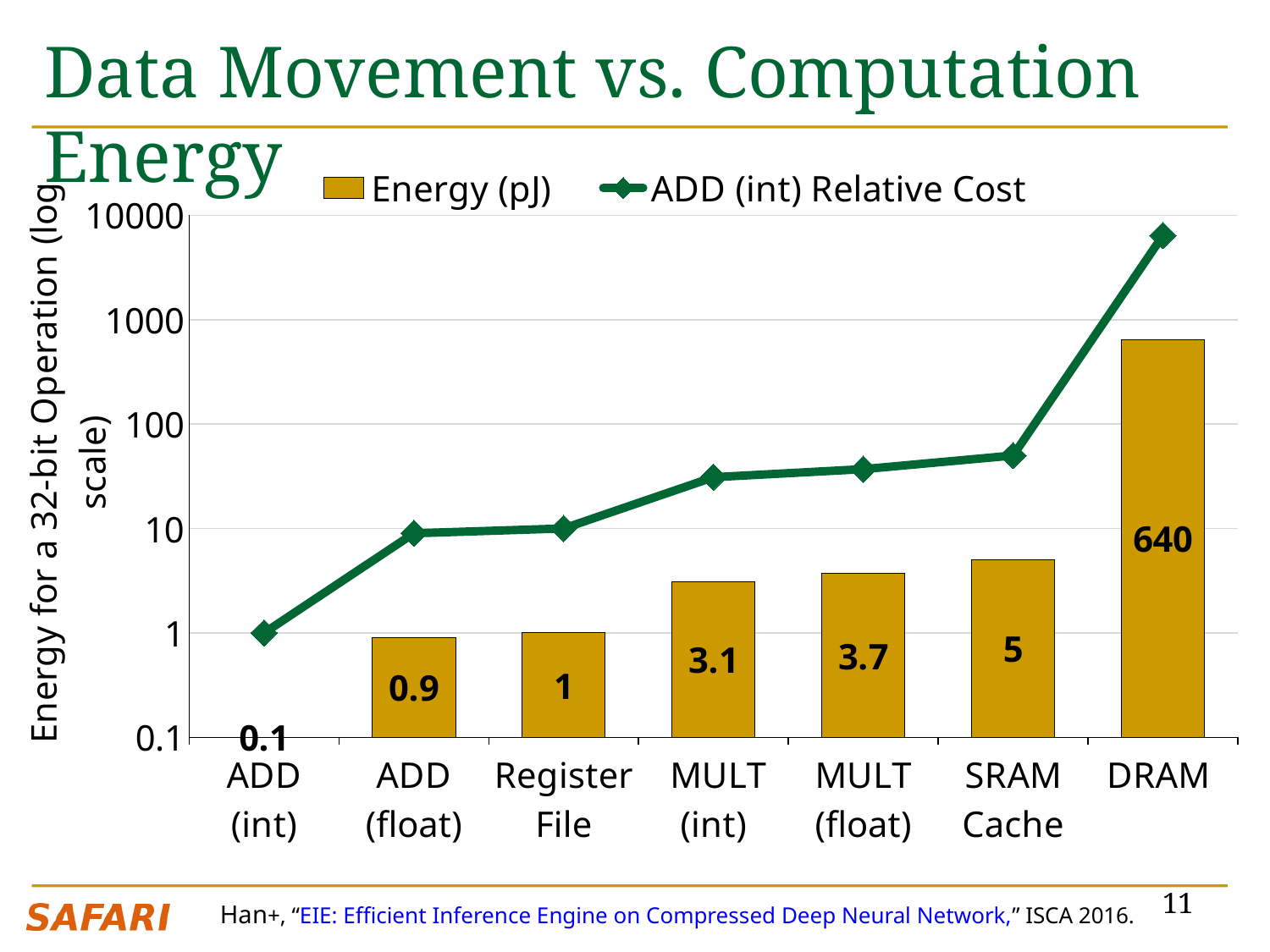
Do the Energy (pJ) values generally rise or fall from ADD (float) to DRAM along the x axis? rise Is the ADD (int) Relative Cost value for SRAM Cache greater or less than 100? less How many series does the legend list? 2 How many categories are shown on the x axis? 7 Is the ADD (int) Relative Cost value for DRAM greater or less than 1000? greater What is the difference in Energy (pJ) between SRAM Cache and MULT (int)? 1.9 Which category has the highest Energy (pJ) value? DRAM What is the Energy (pJ) value for MULT (float)? 3.7 What is the Energy (pJ) value for DRAM? 640 Which has a larger Energy (pJ) value, ADD (float) or MULT (int)? MULT (int) What is the Energy (pJ) value for ADD (int)? 0.1 Which category has the lowest Energy (pJ) value? ADD (int)